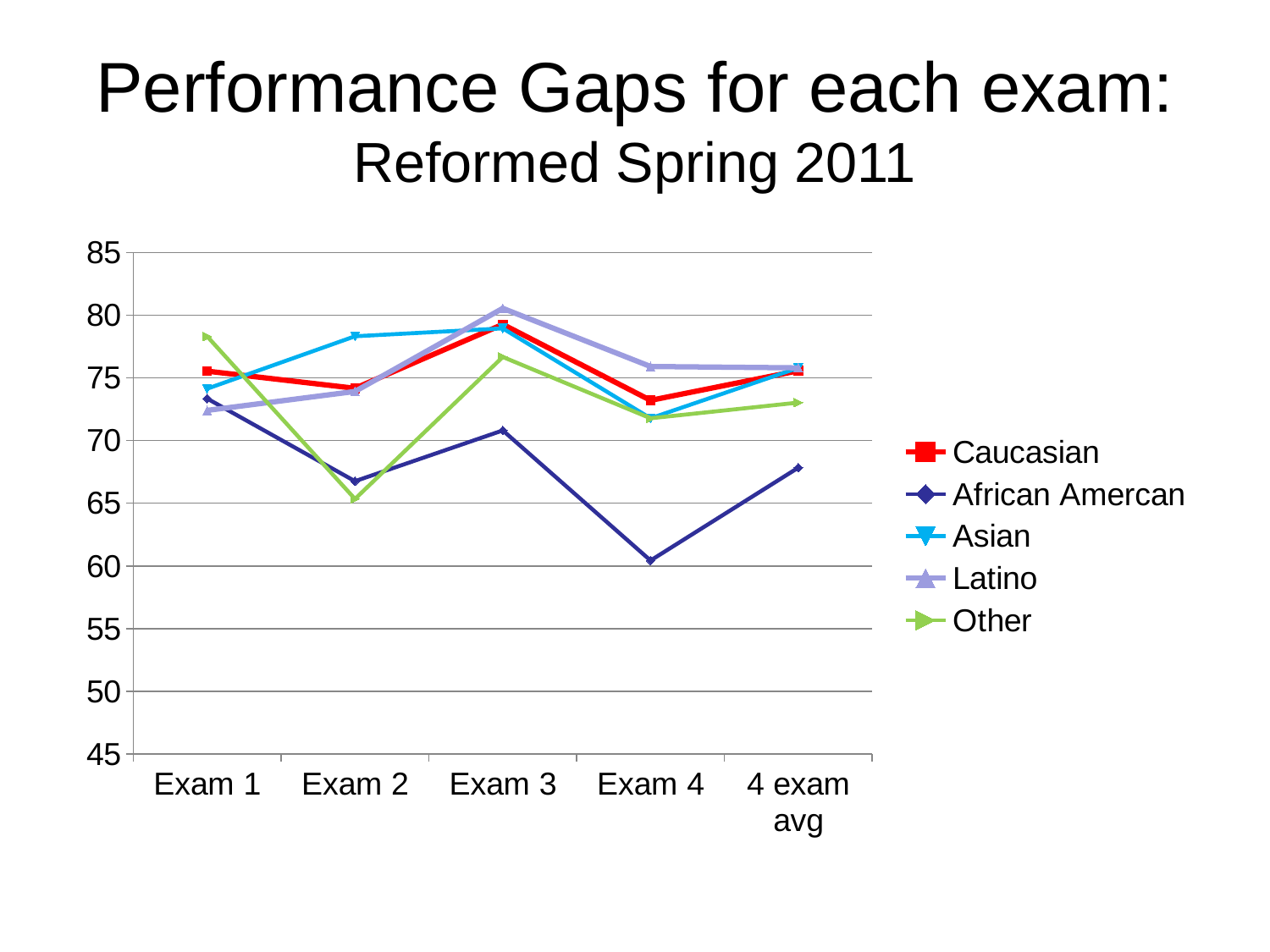
Which series has the highest value at Exam 1? Other Is the value for Asian at Exam 2 greater or less than 75? greater Which series has the lowest value at Exam 4? African Amercan What colour is the Caucasian series in the legend? red How many categories are shown along the x axis? 5 How many series does the legend list? 5 What kind of chart is shown on the slide? line chart Which series has the highest value at Exam 2? Asian At Exam 1, which is larger: the value for Other or the value for African Amercan? Other Is the value for Other at Exam 2 greater or less than 70? less Does the African Amercan series rise or fall from Exam 3 to Exam 4? fall Is the value for African Amercan at Exam 4 greater or less than 65? less